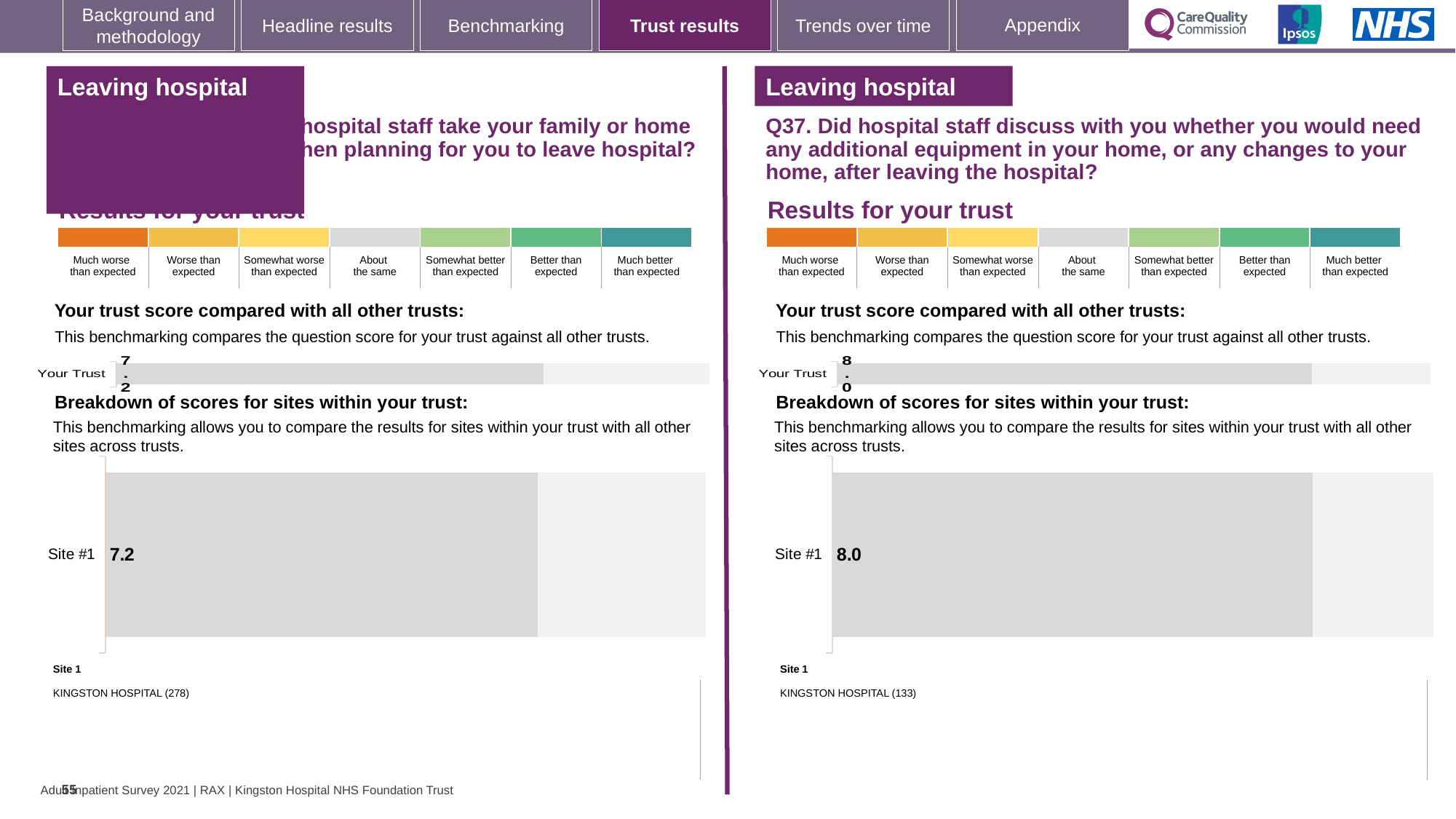
What site name is listed under 'Site 1' for the left-hand chart? KINGSTON HOSPITAL (278) In the right-hand 'Breakdown of scores for sites within your trust' chart (Q37), what is the score for Site #1? 8.0 How many categories does the colour scale above the left-hand 'Results for your trust' section list, from 'Much worse than expected' to 'Much better than expected'? 7 Which has the higher 'Your Trust' score: the left-hand chart or the right-hand chart (Q37)? the right-hand chart (Q37) What is the difference between the Site #1 score on the right-hand chart (Q37) and the Site #1 score on the left-hand chart? 0.8 How many sites are shown in the left-hand 'Breakdown of scores for sites within your trust' chart? 1 On the right-hand chart (Q37), what is the 'Your Trust' score shown? 8.0 On the left-hand chart, what is the 'Your Trust' score shown? 7.2 What type of chart is used to show the Site #1 score on the left-hand side of the slide? bar chart Which has the higher Site #1 score: the left-hand chart or the right-hand chart (Q37)? the right-hand chart (Q37) How many sites are shown in the right-hand 'Breakdown of scores for sites within your trust' chart (Q37)? 1 In the left-hand 'Breakdown of scores for sites within your trust' chart, what is the score for Site #1? 7.2